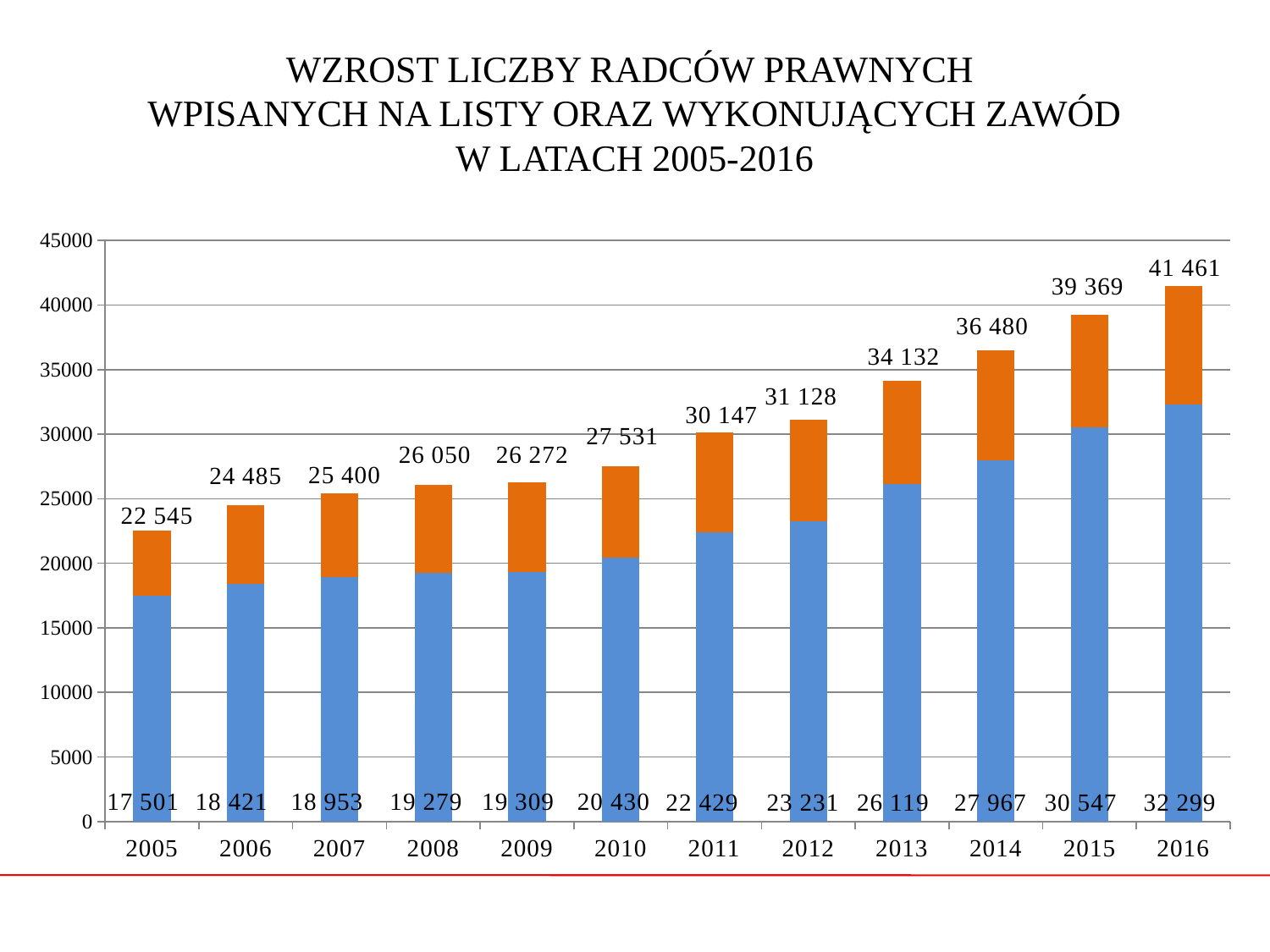
How many years are shown on the x axis? 12 Which year has the highest total value? 2016 What is the value printed on the blue segment of the bar for 2010? 20 430 Is the total value for 2014 greater or less than 35000? greater Do the total values rise or fall from 2005 to 2016? Rise Which year has the lowest total value? 2005 What kind of chart is shown on the slide? Stacked bar chart What is the difference between the blue segment values for 2012 and 2011? 802 Which year has the larger blue segment value, 2008 or 2009? 2009 What is the difference between the total values for 2016 and 2015? 2 092 What is the total value printed above the bar for 2013? 34 132 By how much does the total for 2005 exceed the blue segment value for 2005? 5 044